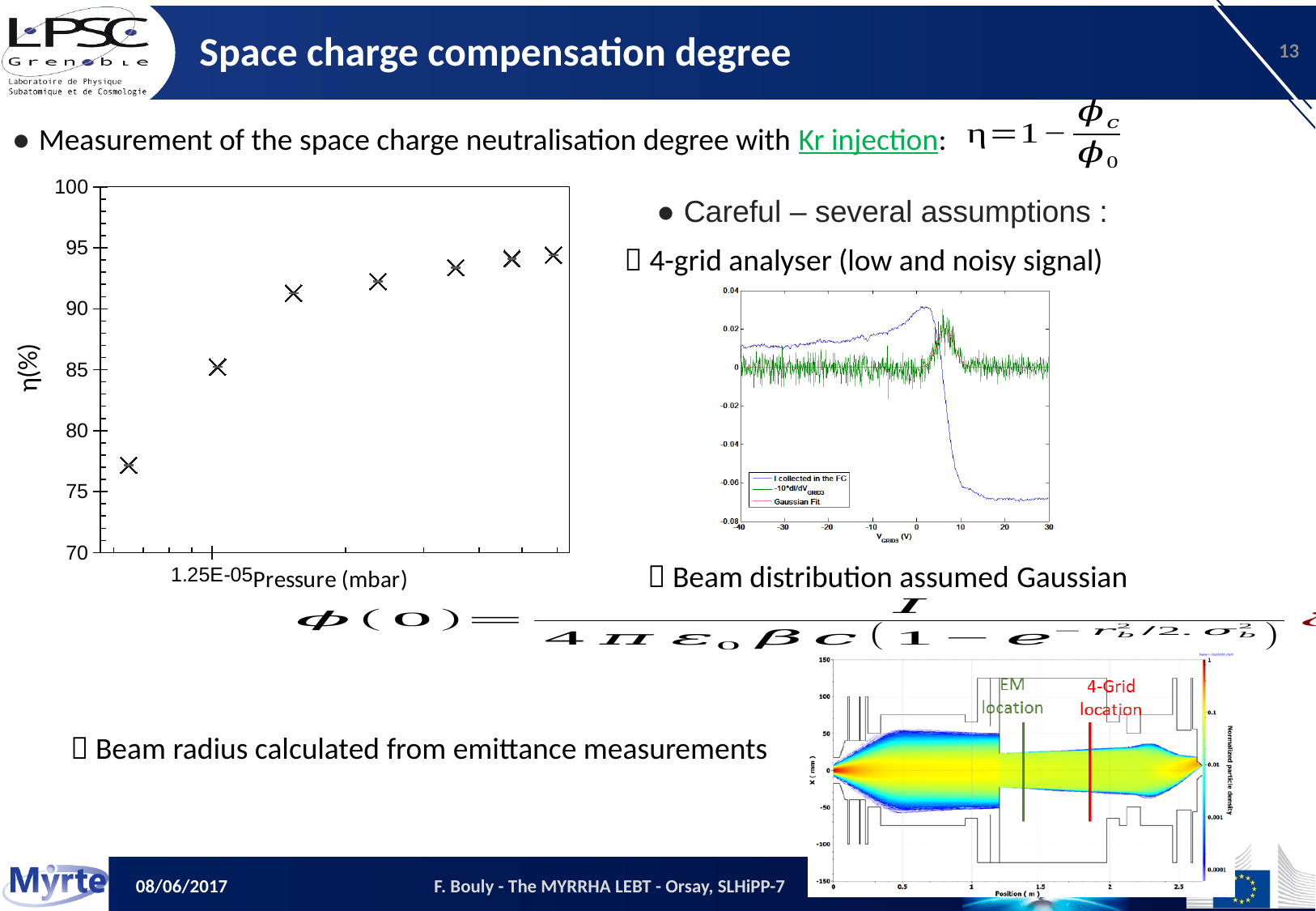
What is the only pressure value printed as a tick label on the x axis of the η(%) versus Pressure (mbar) chart? 1.25E-05 How many data points are plotted in the η(%) versus Pressure (mbar) chart? 7 In the η(%) versus Pressure (mbar) chart, which point has the lowest η value, the leftmost or the rightmost? the leftmost In the η(%) versus Pressure (mbar) chart, is the value of the third point from the left greater or less than 90? greater In the η(%) versus Pressure (mbar) chart, is the value of the rightmost point greater or less than 95? less What kind of chart is the η(%) versus Pressure (mbar) plot on the left of the slide? scatter chart What is the label on the y axis of the scatter chart on the left of the slide? η(%) In the η(%) versus Pressure (mbar) chart, do the values rise or fall as pressure increases along the x axis? rise In the η(%) versus Pressure (mbar) chart, which is larger: the η value of the leftmost point or of the second point from the left? the second point from the left How many series does the legend list in the 4-grid analyser signal plot on the right of the slide? 3 In the η(%) versus Pressure (mbar) chart, is the value of the leftmost (lowest-pressure) point greater or less than 80? less